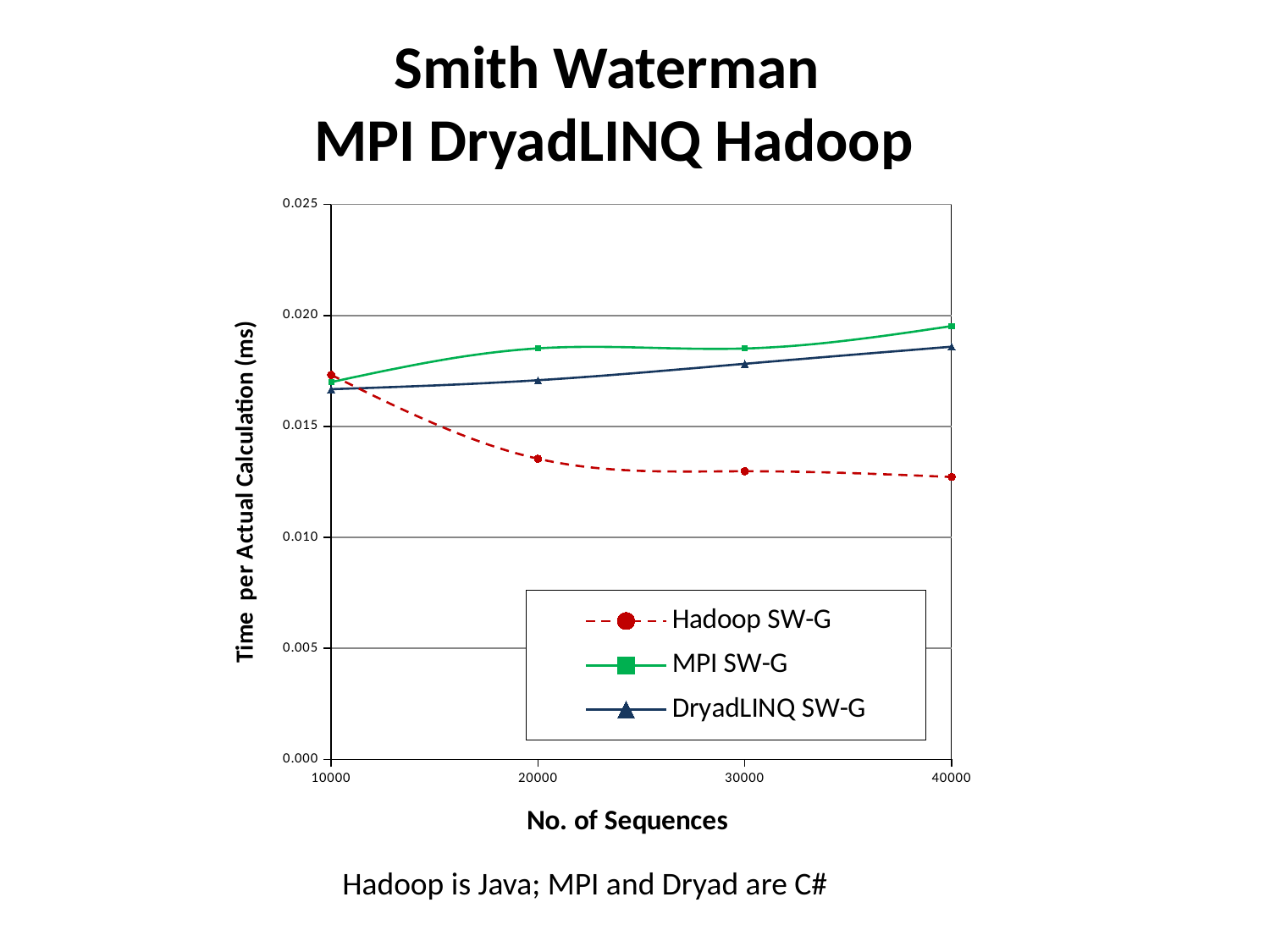
How many points along the x axis are plotted for each series? 4 At 30000 sequences, which is larger: MPI SW-G or DryadLINQ SW-G? MPI SW-G Is the value for MPI SW-G at 40000 sequences greater or less than 0.015? greater How many series does the legend list? 3 Is the value for MPI SW-G at 40000 sequences greater or less than 0.020? less What kind of chart is shown on the slide? line chart Is the value for Hadoop SW-G at 40000 sequences greater or less than 0.015? less What is the label of the y axis? Time per Actual Calculation (ms) Does the Hadoop SW-G line rise or fall as the number of sequences increases? fall Which series has the lowest value at 40000 sequences? Hadoop SW-G Which series has the highest value at 40000 sequences? MPI SW-G